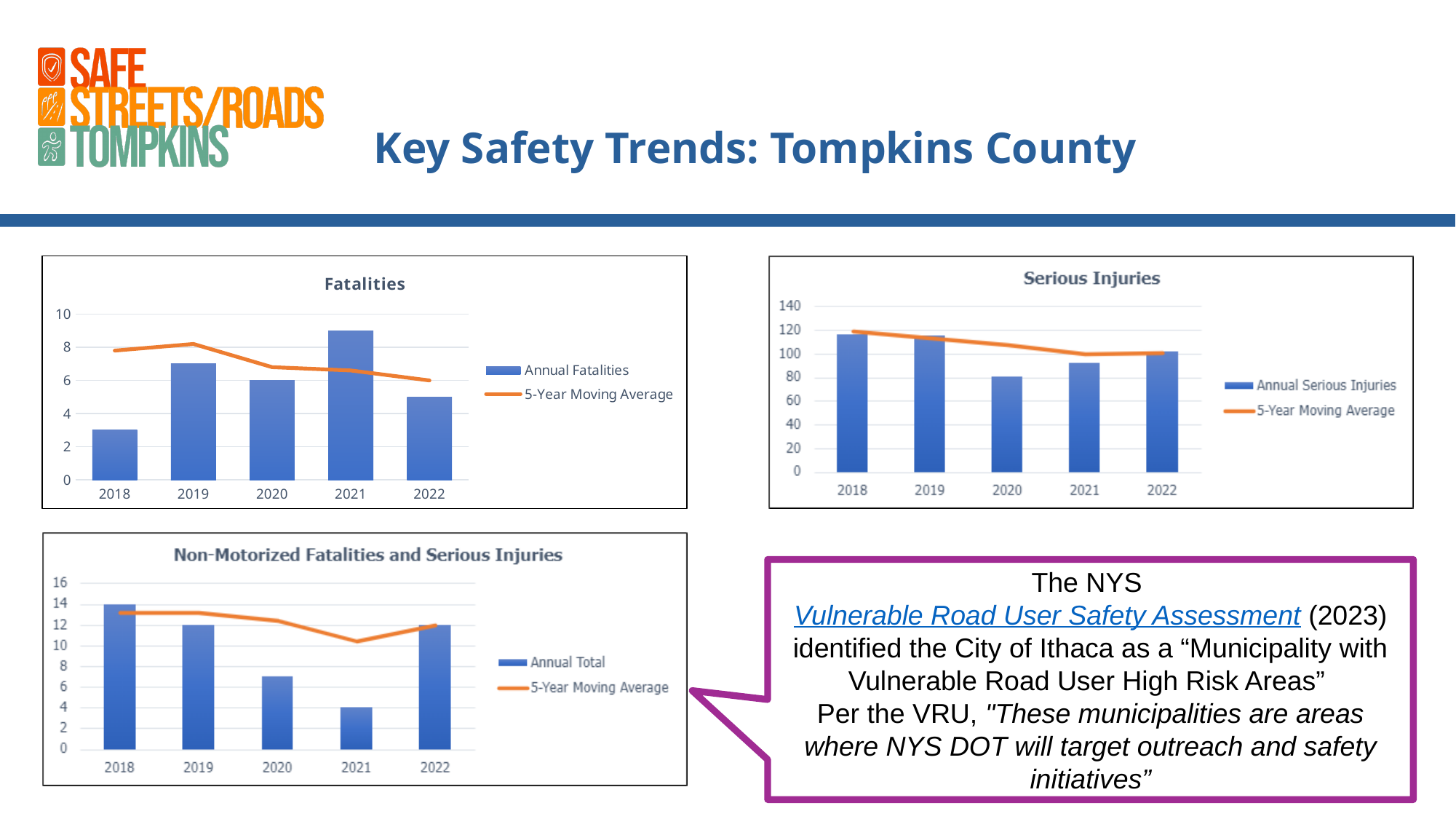
How many years are shown on the x axis of the Serious Injuries chart? 5 In the Non-Motorized Fatalities and Serious Injuries chart, what is the Annual Total value for 2018? 14 In the Serious Injuries chart, is the Annual Serious Injuries value for 2018 greater or less than 100? greater In the Fatalities chart, is the Annual Fatalities value for 2021 greater or less than 8? greater How many series does the legend of the Non-Motorized Fatalities and Serious Injuries chart list? 2 In the Serious Injuries chart, which is larger, the Annual Serious Injuries bar for 2019 or for 2021? 2019 In the Fatalities chart, which year has the highest annual fatalities bar? 2021 In the Non-Motorized Fatalities and Serious Injuries chart, what is the difference between the Annual Total for 2018 and 2021? 10 In the Fatalities chart, which year has the lowest annual fatalities bar? 2018 In the Non-Motorized Fatalities and Serious Injuries chart, what is the Annual Total value for 2021? 4 In the Fatalities chart, what is the value of the Annual Fatalities bar for 2020? 6 In the Serious Injuries chart, which year has the lowest annual serious injuries bar? 2020